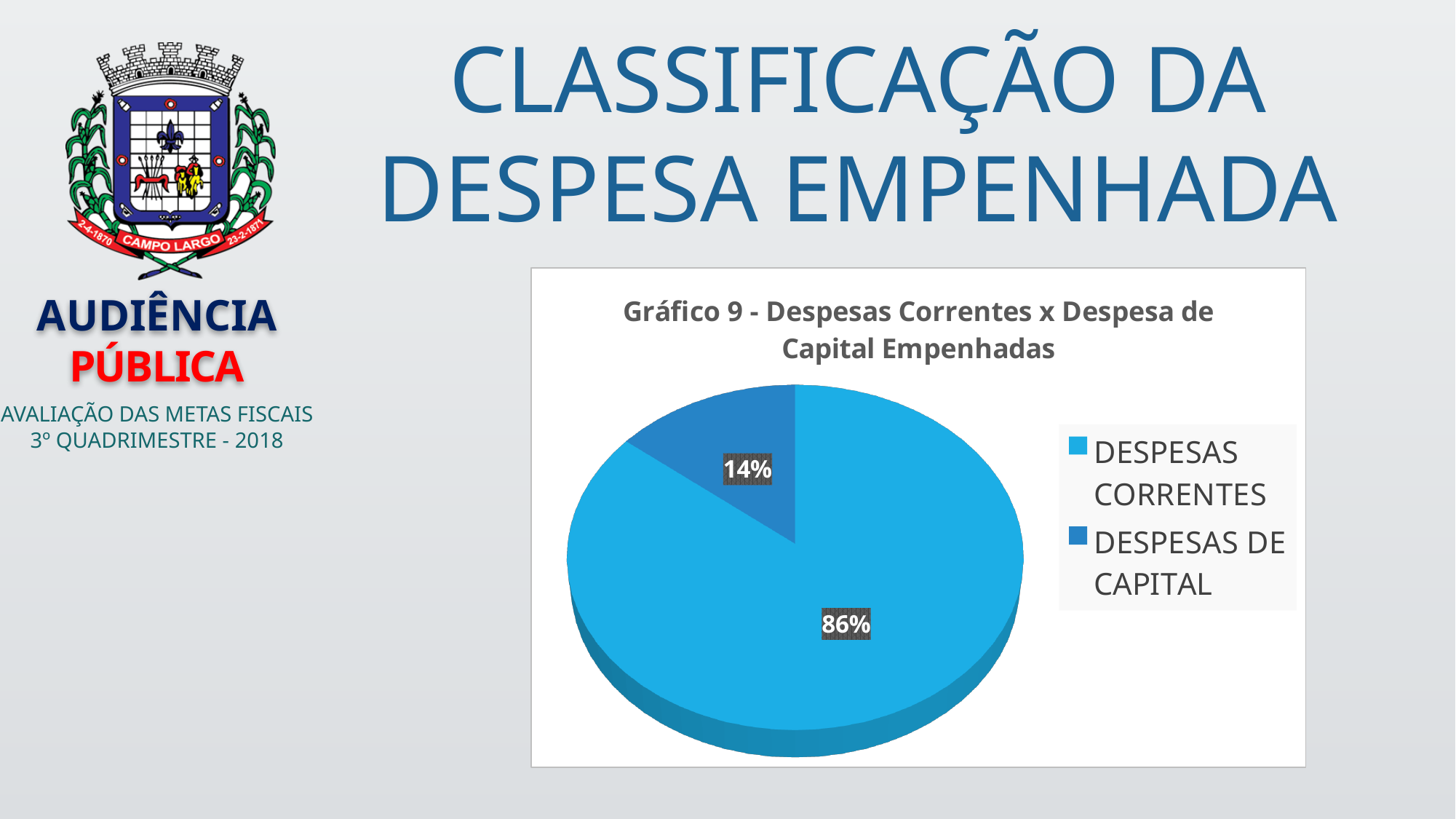
How many categories does the pie chart show? 2 What share of the pie does DESPESAS CORRENTES represent? 86% What is the total of the two percentages shown on the pie chart? 100% Which category is shown in the darker blue colour in the legend? DESPESAS DE CAPITAL What kind of chart is shown on the slide? Pie chart Which category has the smallest slice of the pie? DESPESAS DE CAPITAL Which is larger, the share for DESPESAS CORRENTES or for DESPESAS DE CAPITAL? DESPESAS CORRENTES Which category has the largest slice of the pie? DESPESAS CORRENTES What share of the pie does DESPESAS DE CAPITAL represent? 14% What is the title of the chart? Gráfico 9 - Despesas Correntes x Despesa de Capital Empenhadas What is the difference in percentage points between DESPESAS CORRENTES and DESPESAS DE CAPITAL? 72